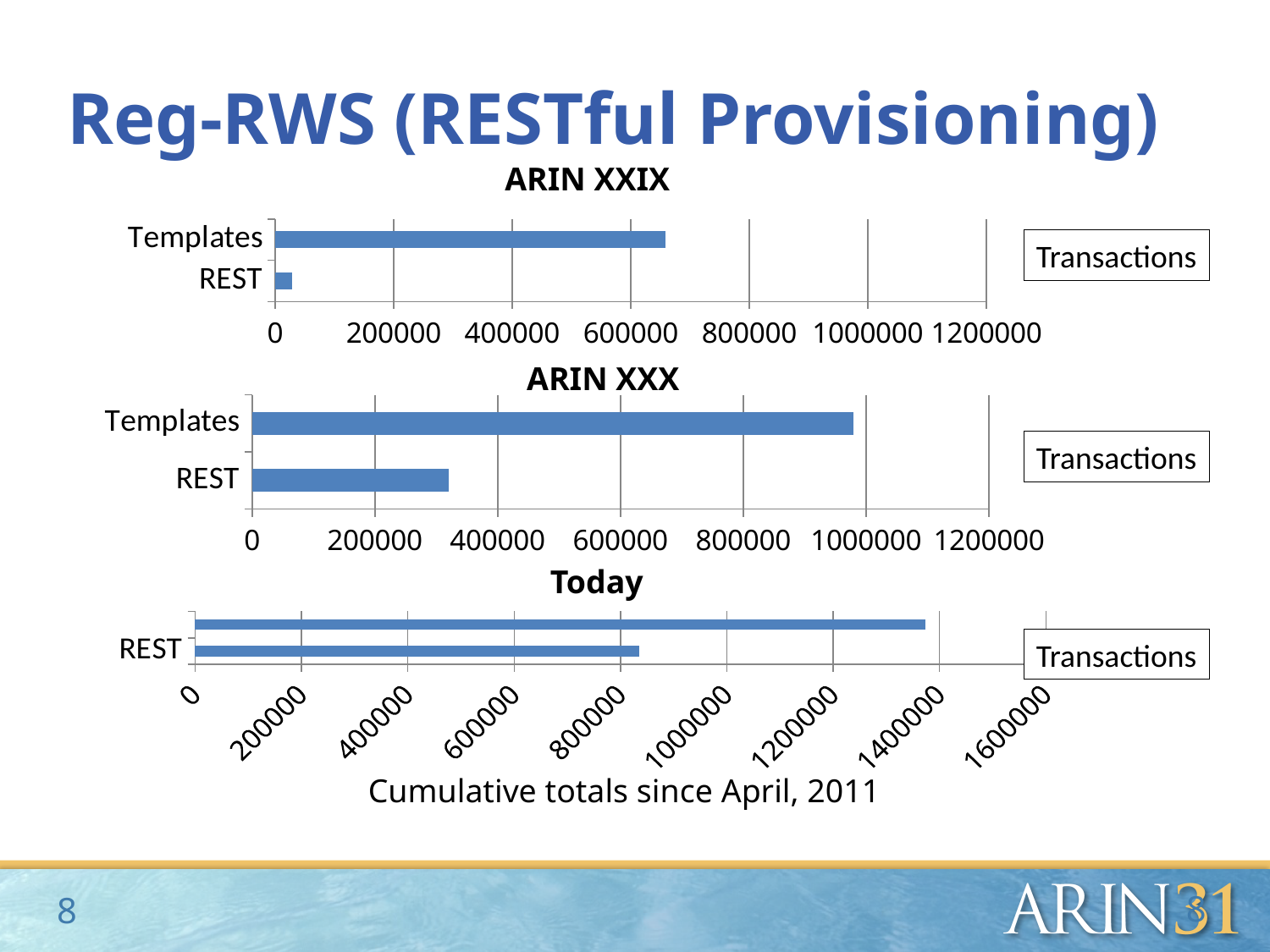
In the ARIN XXIX chart, which category has the higher value, Templates or REST? Templates In the ARIN XXX chart, how many series does the legend list? 1 In the ARIN XXIX chart, is the value for REST greater or less than 200000? less In the Today chart, is the longer bar greater or less than 1200000? greater In the Today chart, what is the highest value shown on the x axis? 1600000 In the ARIN XXIX chart, how many categories are plotted? 2 In the ARIN XXX chart, is the value for Templates greater or less than 800000? greater What legend entry appears in the ARIN XXX chart? Transactions In the ARIN XXX chart, which category has the lowest value? REST In the ARIN XXIX chart, what kind of chart is shown? bar chart